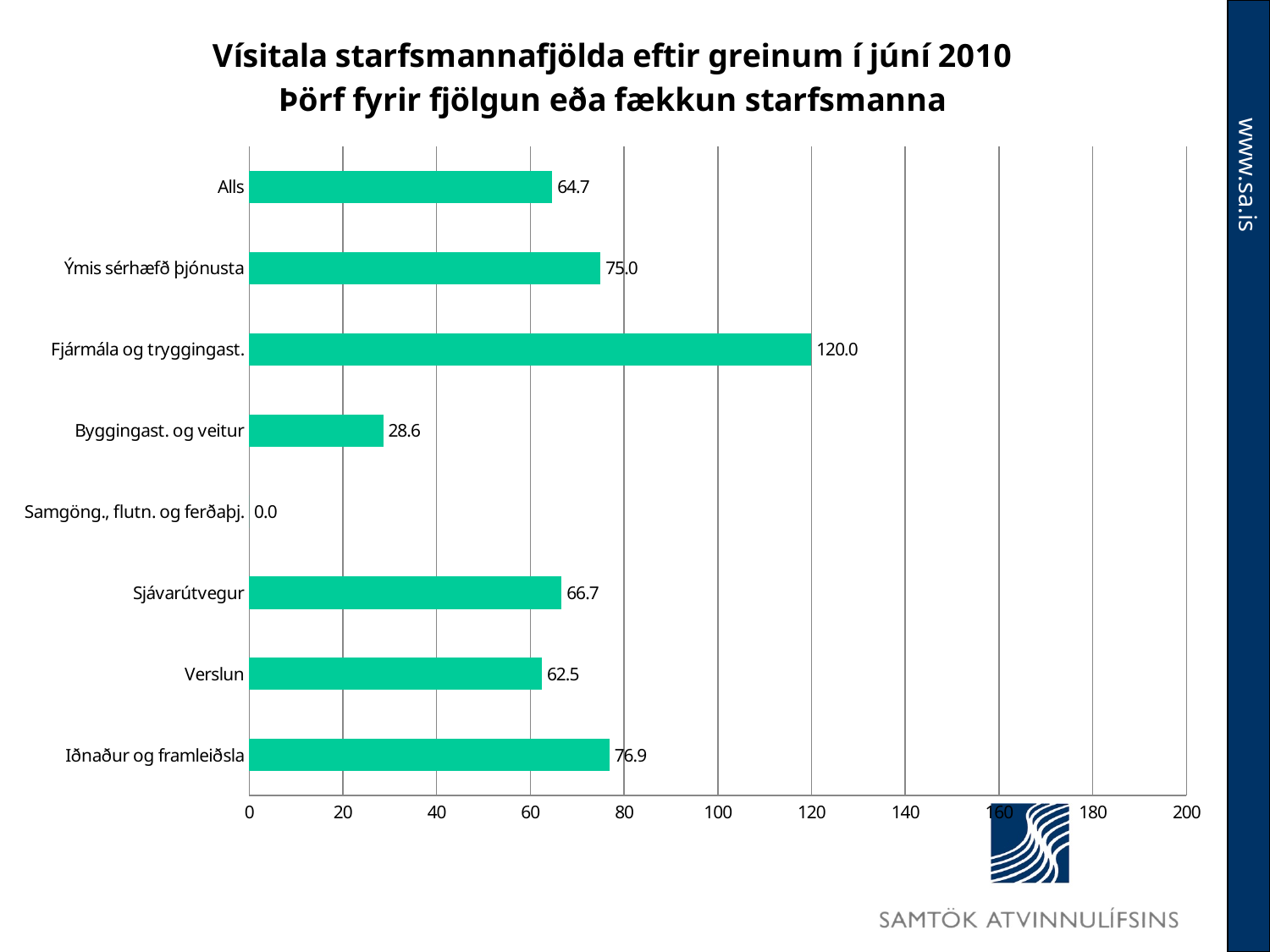
Which category has the lowest value? Samgöng., flutn. og ferðaþj. Is the value for Ýmis sérhæfð þjónusta greater or less than 60? greater What kind of chart is shown on the slide? bar chart What is the value for Byggingast. og veitur? 28.6 What is the value for Iðnaður og framleiðsla? 76.9 Which is larger, the value for Sjávarútvegur or the value for Verslun? Sjávarútvegur What is the difference between the values for Fjármála og tryggingast. and Ýmis sérhæfð þjónusta? 45.0 Which category has the highest value? Fjármála og tryggingast. What is the value for Alls? 64.7 What is the value for Fjármála og tryggingast.? 120.0 What is the title of the chart? Vísitala starfsmannafjölda eftir greinum í júní 2010 Þörf fyrir fjölgun eða fækkun starfsmanna How many categories are shown on the chart? 8